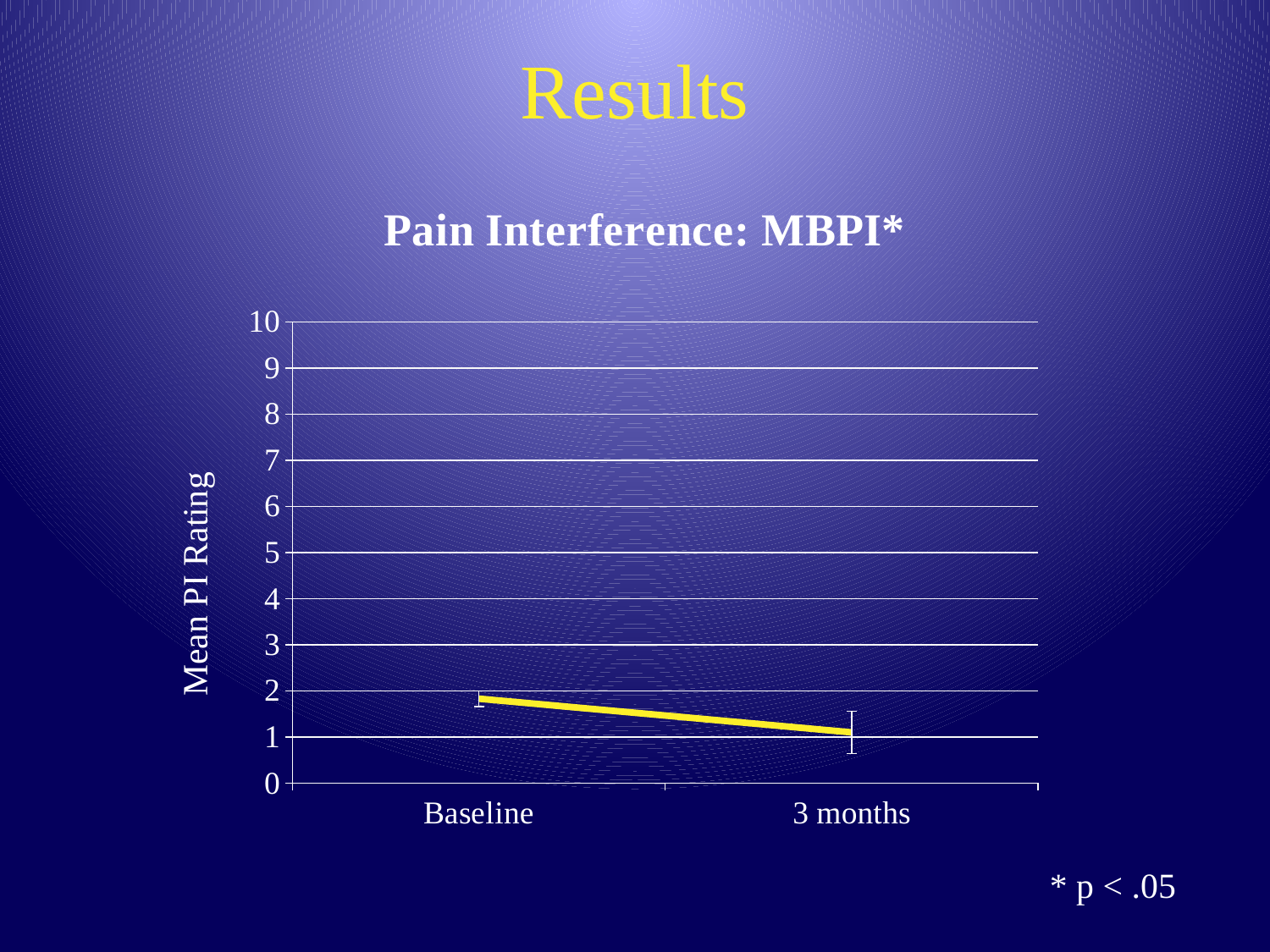
What is the label on the y axis of the chart? Mean PI Rating Which time point has the lowest Mean PI Rating? 3 months What is the title of the chart? Pain Interference: MBPI* Which time point has the higher Mean PI Rating, Baseline or 3 months? Baseline How many time points are plotted on the x axis? 2 Does the Mean PI Rating rise or fall from Baseline to 3 months? fall Is the Mean PI Rating at Baseline greater or less than 3? less Which time point has the highest Mean PI Rating? Baseline Is the Mean PI Rating at 3 months greater or less than 2? less What kind of chart is shown on the slide? line chart Is the Mean PI Rating at Baseline greater or less than 1? greater